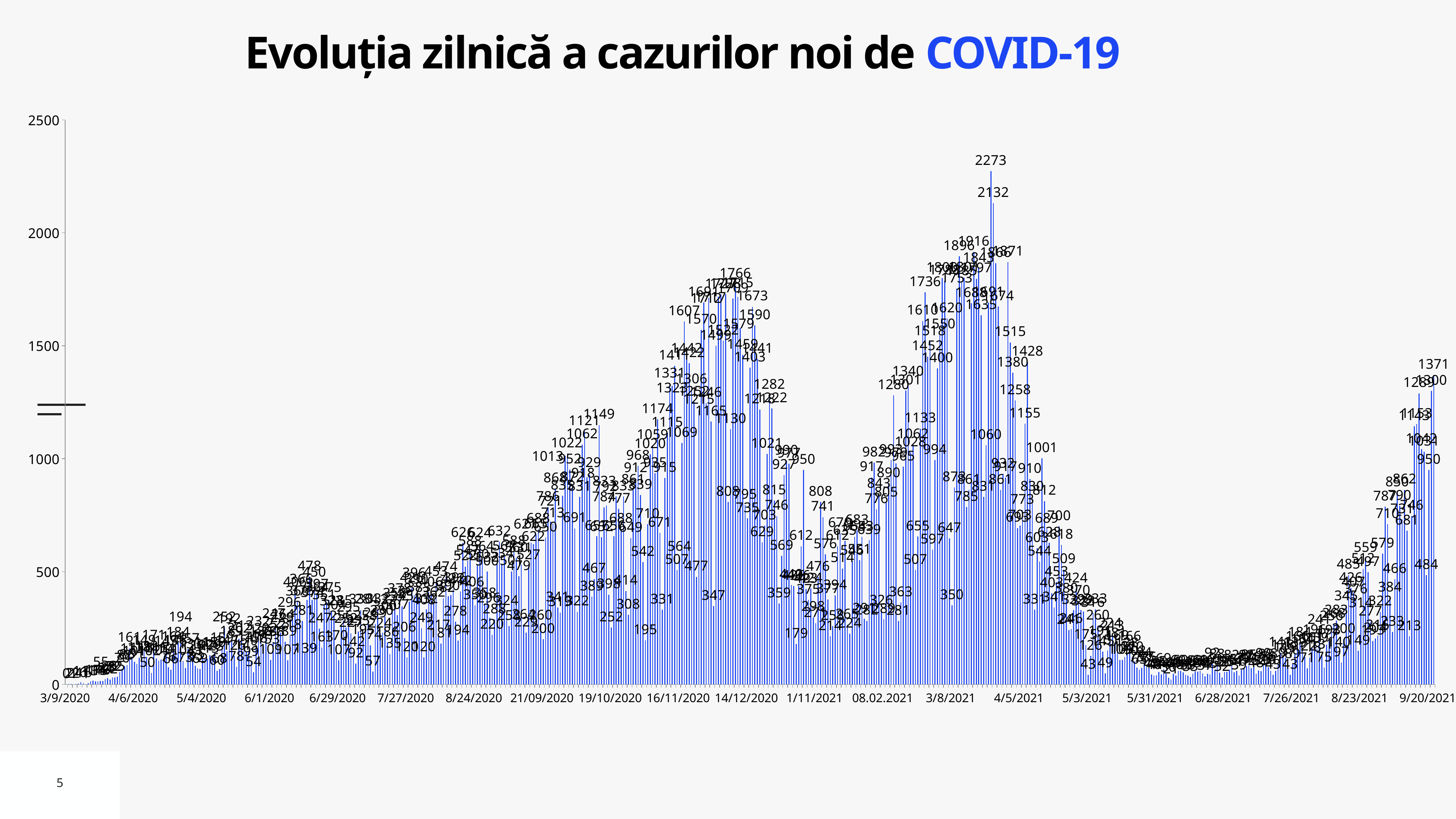
What is the title of the chart? Evoluția zilnică a cazurilor noi de COVID-19 Is the value for 3/9/2020 greater or less than 500? less Is the value for 6/28/2021 greater or less than 500? less What is the difference between the two highest labelled values, 2273 and 2132? 141 Between 7/26/2021 and 9/20/2021, do the daily values generally rise or fall? rise What is the highest daily value labelled on the chart? 2273 Which is larger: the peak value near 4/5/2021 or the peak value near 14/12/2020? the peak near 4/5/2021 What is the highest tick value shown on the vertical axis? 2500 What kind of chart is shown on the slide? bar chart What is the second-highest data label shown on the chart, just after the 2273 peak? 2132 What is the highest data label in the wave around 14/12/2020? 1766